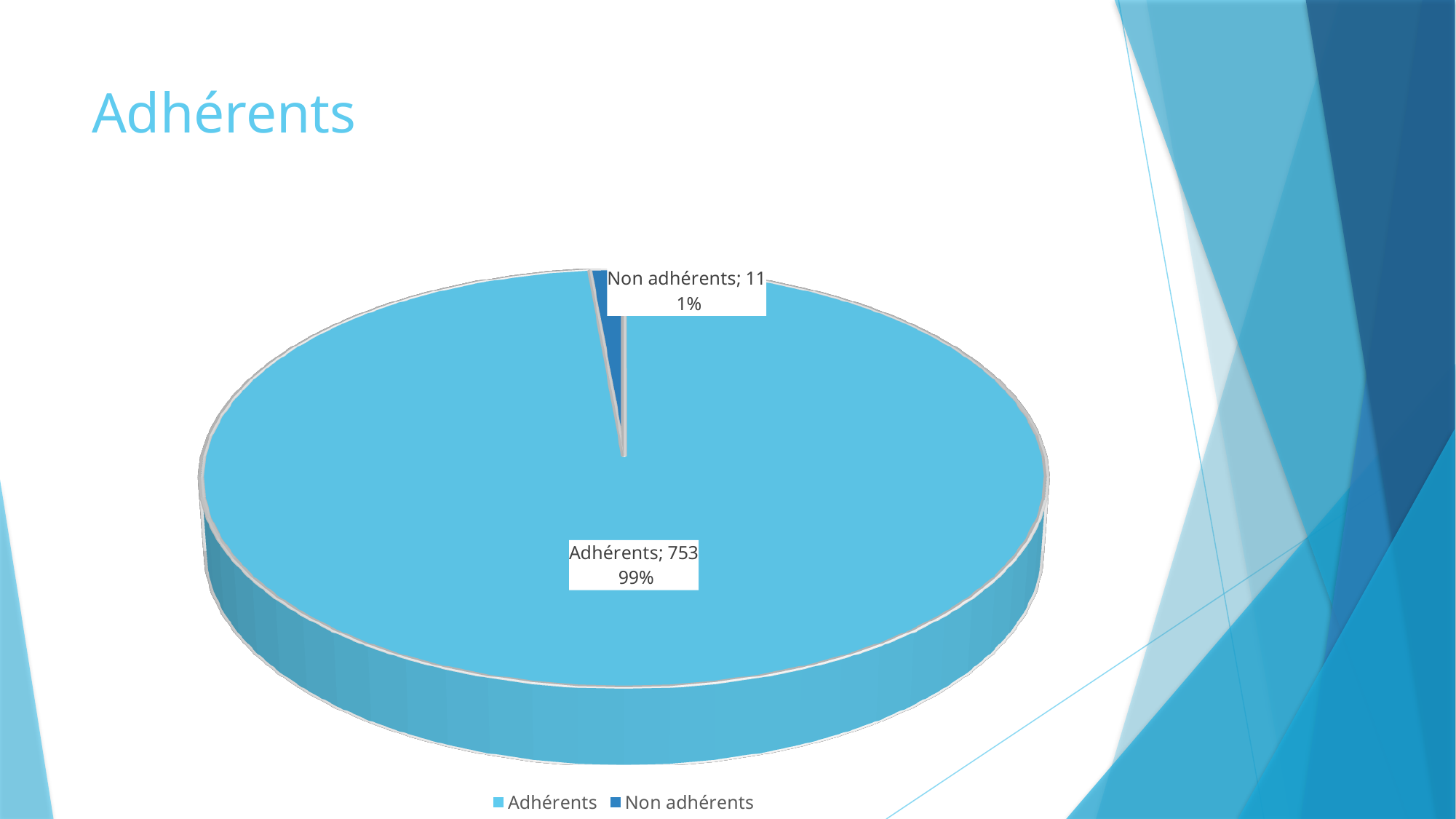
Which category has the largest slice? Adhérents Which is larger, the value for Adhérents or the value for Non adhérents? Adhérents What is the title of the slide? Adhérents What is the value for Non adhérents? 11 What kind of chart is shown on the slide? pie chart What share of the pie does the Non adhérents slice represent? 1% Which category has the smallest slice? Non adhérents What is the value for Adhérents? 753 How many categories does the pie chart have? 2 What is the total of the two values shown in the pie chart? 764 What is the difference between the values for Adhérents and Non adhérents? 742 What share of the pie does the Adhérents slice represent? 99%